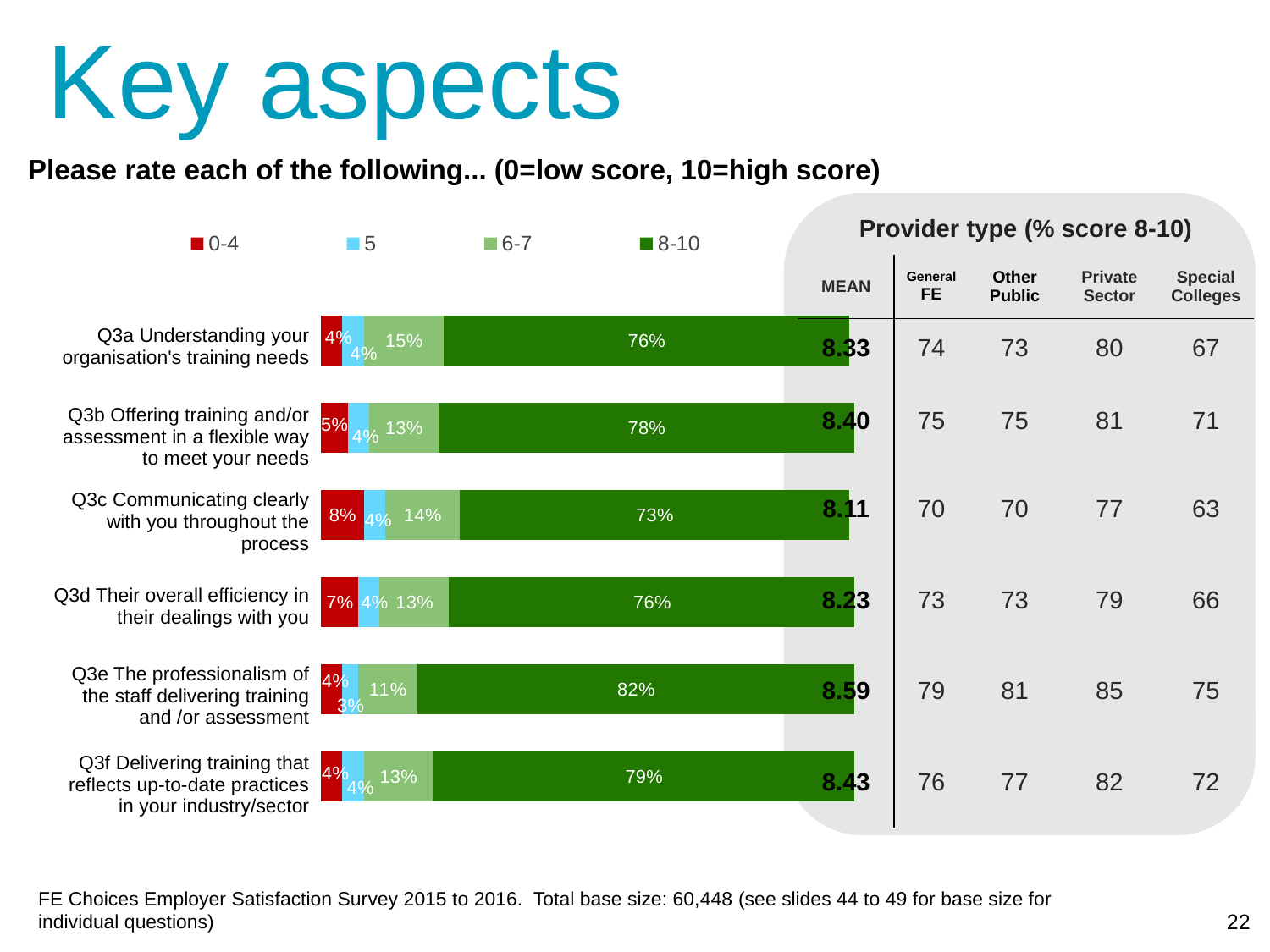
Which question has the highest percentage of 0-4 scores? Q3c Communicating clearly with you throughout the process What percentage of respondents gave a score of 6-7 for Q3a Understanding your organisation's training needs? 15% How many questions (categories) are shown in the chart? 6 What percentage of respondents gave a score of 0-4 for Q3c Communicating clearly with you throughout the process? 8% Which question has the highest percentage of 8-10 scores? Q3e The professionalism of the staff delivering training and /or assessment What are the four score bands listed in the chart legend? 0-4, 5, 6-7, 8-10 What percentage of respondents gave a score of 8-10 for Q3c Communicating clearly with you throughout the process? 73% How many series does the chart legend list? 4 Which has a larger 8-10 share: Q3b Offering training and/or assessment in a flexible way or Q3f Delivering training that reflects up-to-date practices? Q3f Delivering training that reflects up-to-date practices in your industry/sector What type of chart is used on this slide? Stacked bar chart Which question has the lowest percentage of 8-10 scores? Q3c Communicating clearly with you throughout the process What is the difference in percentage points between the 8-10 share for Q3e and the 8-10 share for Q3c? 9 percentage points